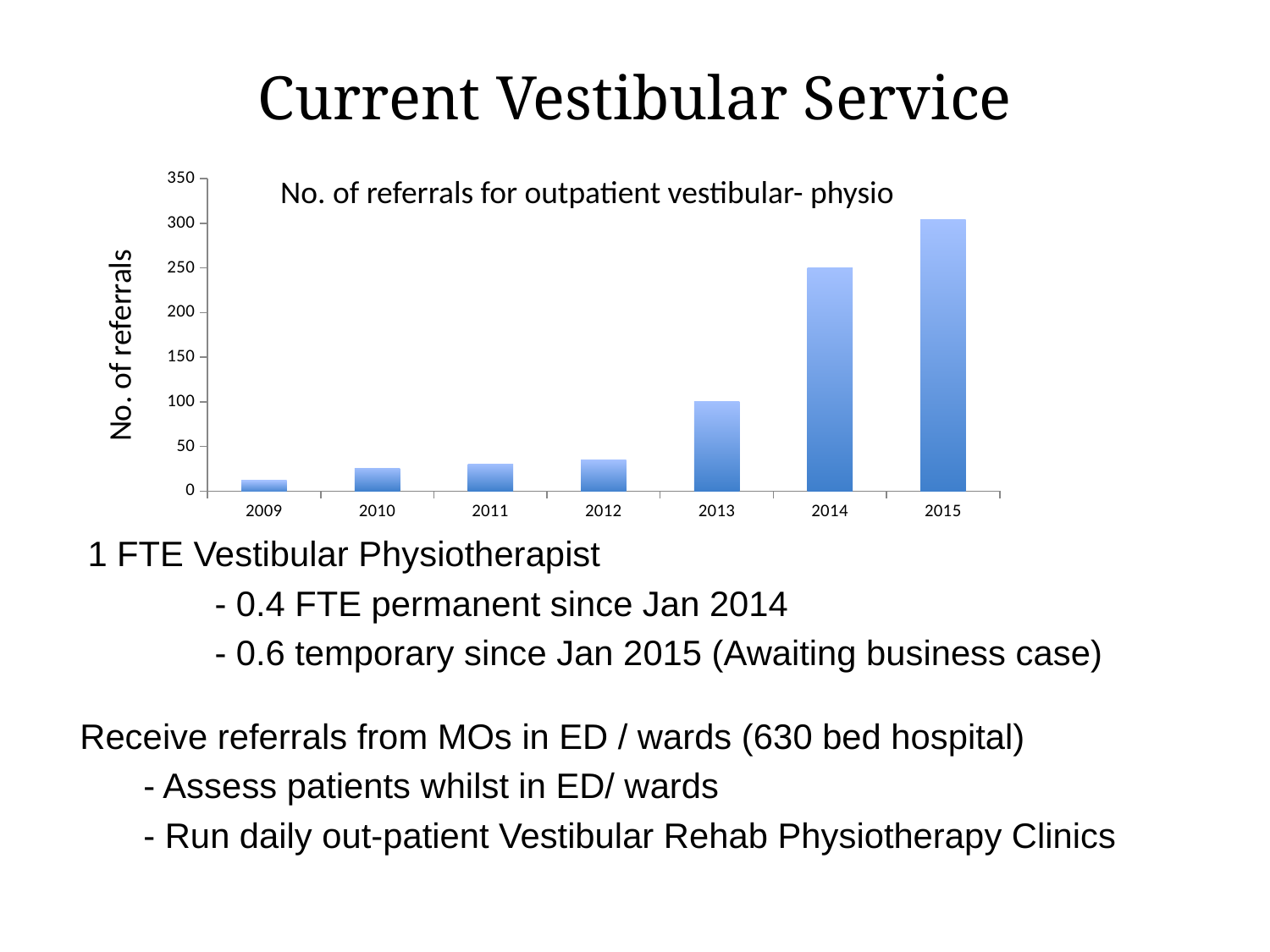
Is the number of referrals for 2012 greater or less than 50? less What is the label on the vertical axis of the chart? No. of referrals Do the number of referrals rise or fall from 2009 to 2015? rise Is the number of referrals for 2009 greater or less than 50? less What is the title of the chart? No. of referrals for outpatient vestibular- physio Which year has the highest number of referrals? 2015 What kind of chart is shown on the slide? bar chart How many years are shown on the x axis of the chart? 7 Is the number of referrals for 2014 greater or less than 200? greater Which year has the lowest number of referrals? 2009 Which year has more referrals, 2013 or 2014? 2014